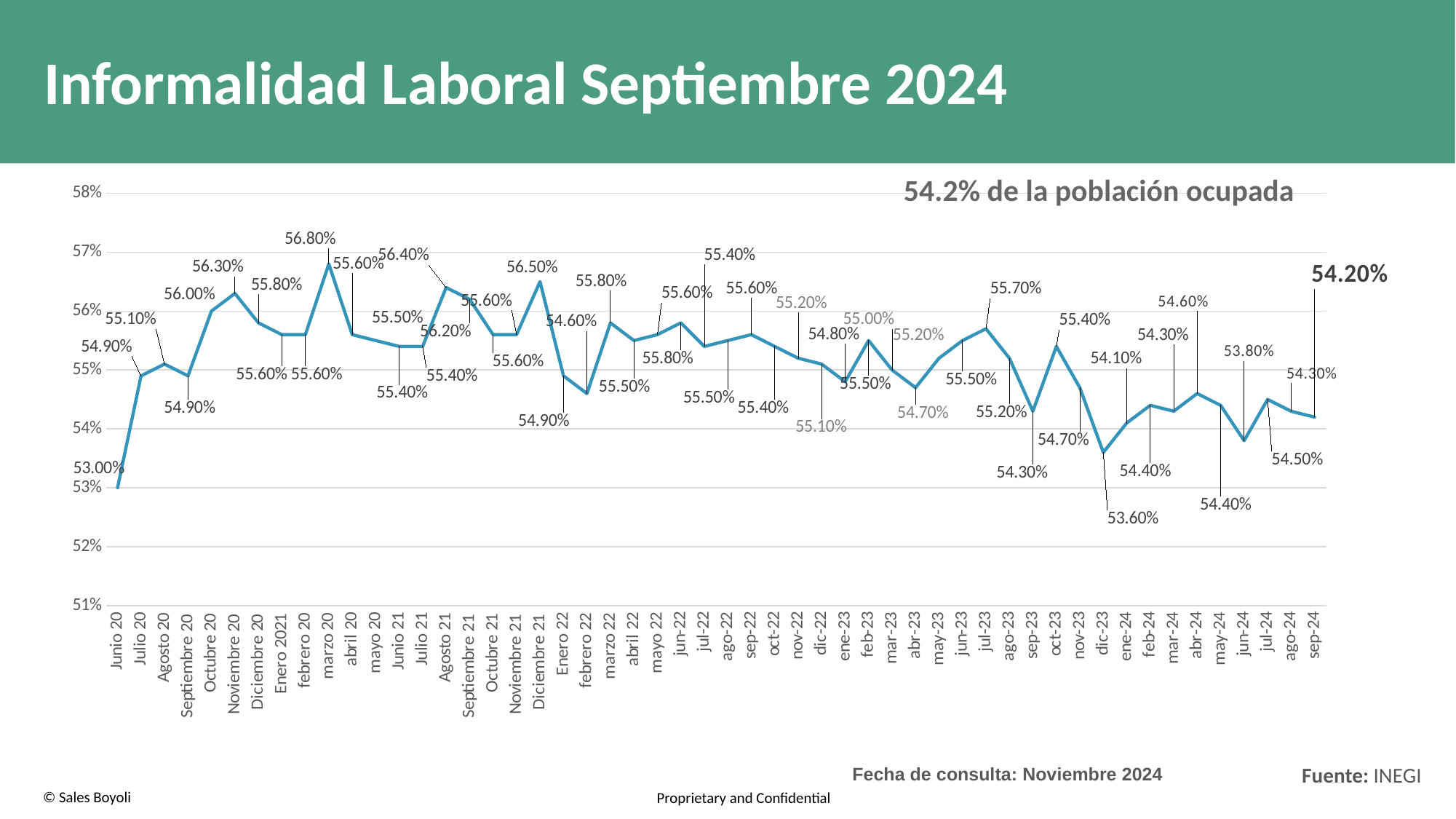
What is the title of the slide? Informalidad Laboral Septiembre 2024 What kind of chart is shown on the slide? line chart Do the values generally rise or fall from jul-23 to sep-24? fall Which is larger, the value for marzo 20 or the value for Diciembre 21? marzo 20 What is the difference between the value for marzo 20 and the value for sep-24? 2.60% Is the value for Junio 20 greater or less than 54%? less What is the value for Noviembre 20? 56.30% Which period has the lowest value on the chart? Junio 20 What is the value for dic-23? 53.60% What is the value for sep-24? 54.20% What is the value for marzo 20? 56.80% Which period has the highest value on the chart? marzo 20